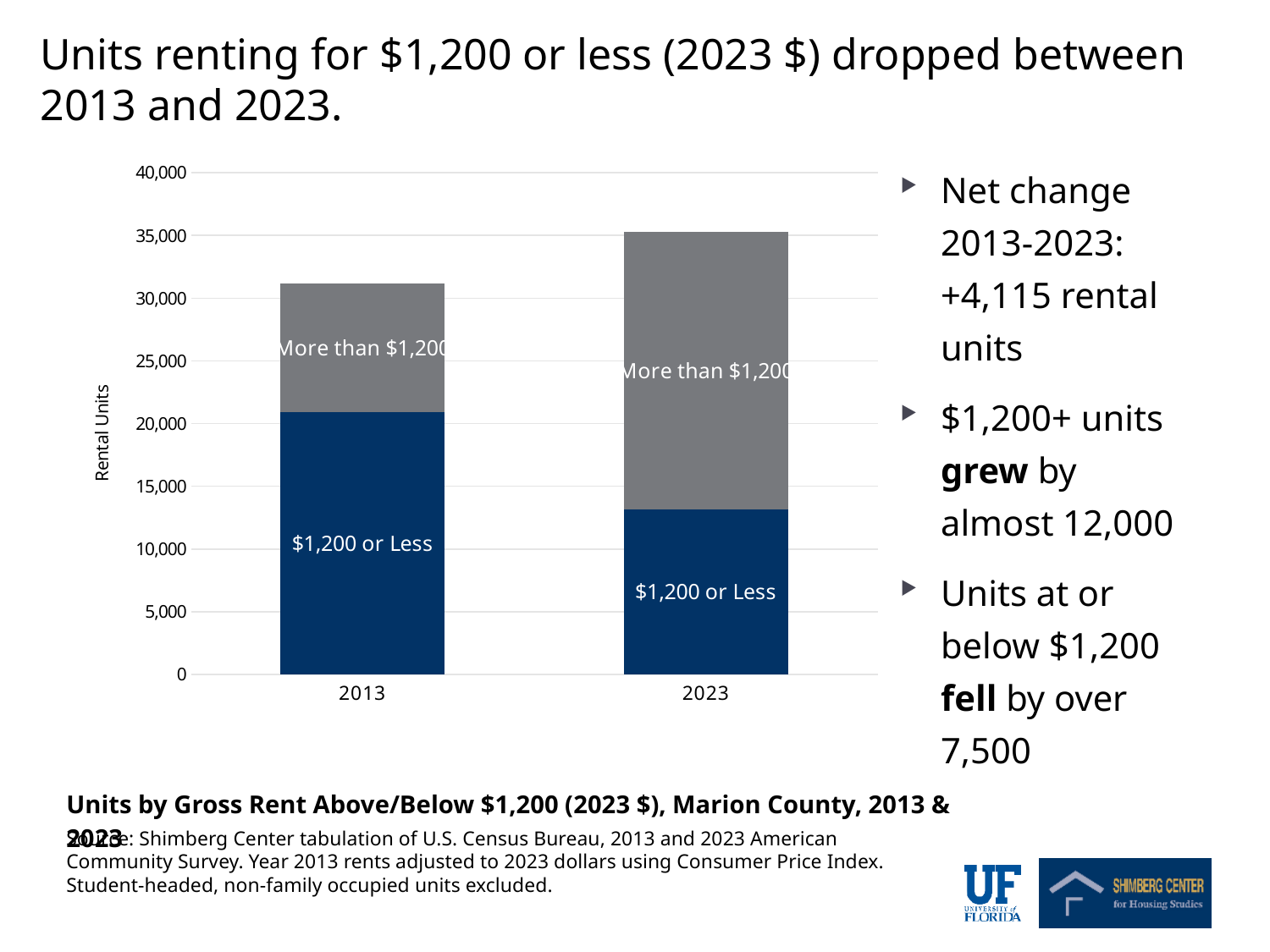
What is the label on the vertical axis of the chart? Rental Units What kind of chart is shown on the slide? Stacked bar chart How many rent segments are stacked in each bar of the chart? 2 Does the number of $1,200 or Less units rise or fall from 2013 to 2023? fall How many years (categories) are shown on the x axis of the chart? 2 Which year has the larger number of More than $1,200 units, 2013 or 2023? 2023 Is the value for $1,200 or Less units in 2023 greater or less than 15,000? less What colour is the $1,200 or Less segment of each bar? Dark blue Is the total height of the 2013 bar greater or less than 35,000? less Which year has the larger number of $1,200 or Less units, 2013 or 2023? 2013 Is the value for $1,200 or Less units in 2013 greater or less than 20,000? greater